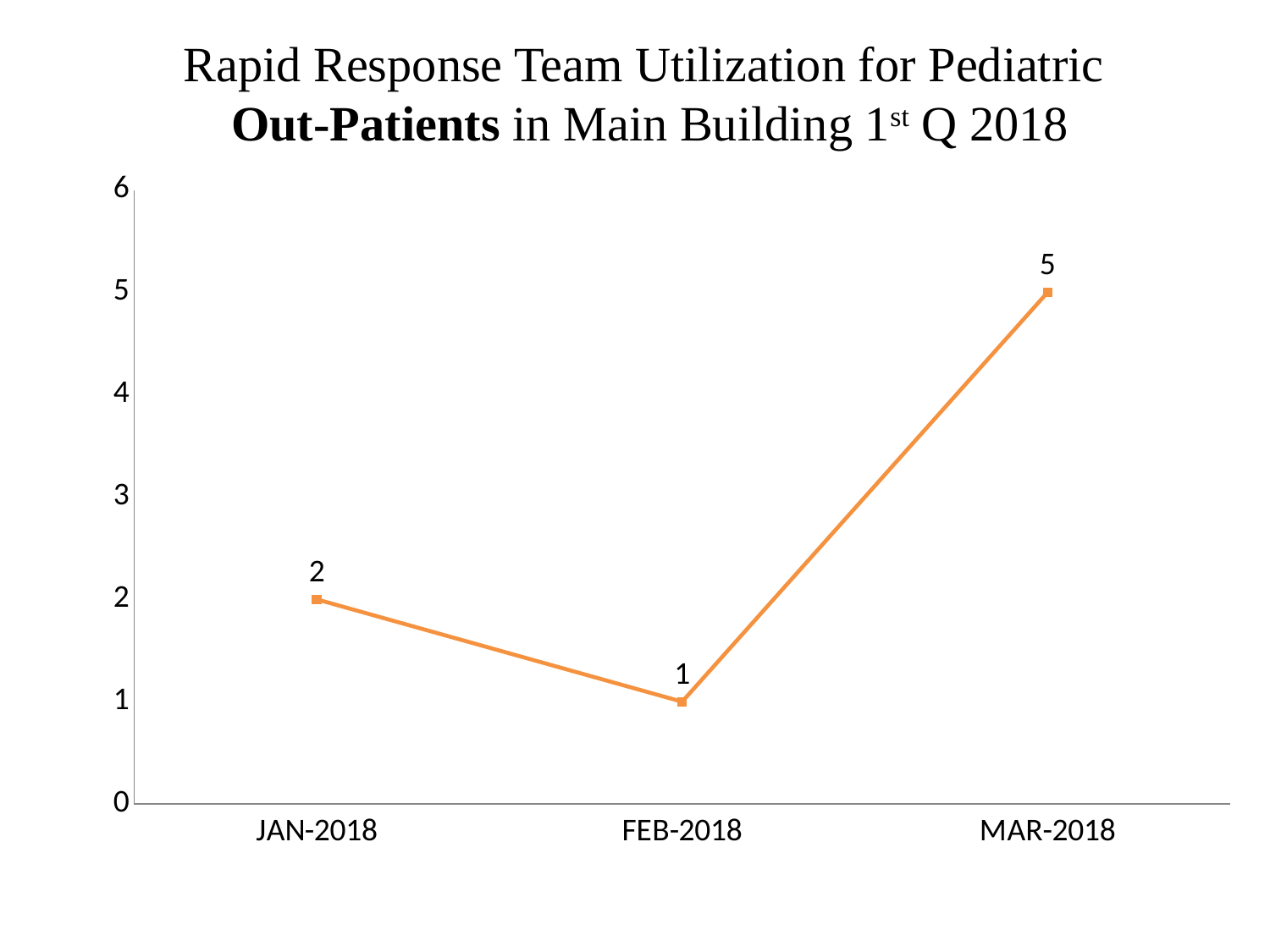
How many months are plotted on the chart? 3 What is the value for JAN-2018? 2 What is the difference between the values for JAN-2018 and FEB-2018? 1 Which month has the lowest value? FEB-2018 Which month has the highest value? MAR-2018 Does the value rise or fall from FEB-2018 to MAR-2018? rise What is the difference between the values for MAR-2018 and FEB-2018? 4 What kind of chart is shown on the slide? line chart What is the value for MAR-2018? 5 What is the value for FEB-2018? 1 Which is larger, the value for JAN-2018 or the value for MAR-2018? MAR-2018 Is the value for MAR-2018 greater or less than 4? greater